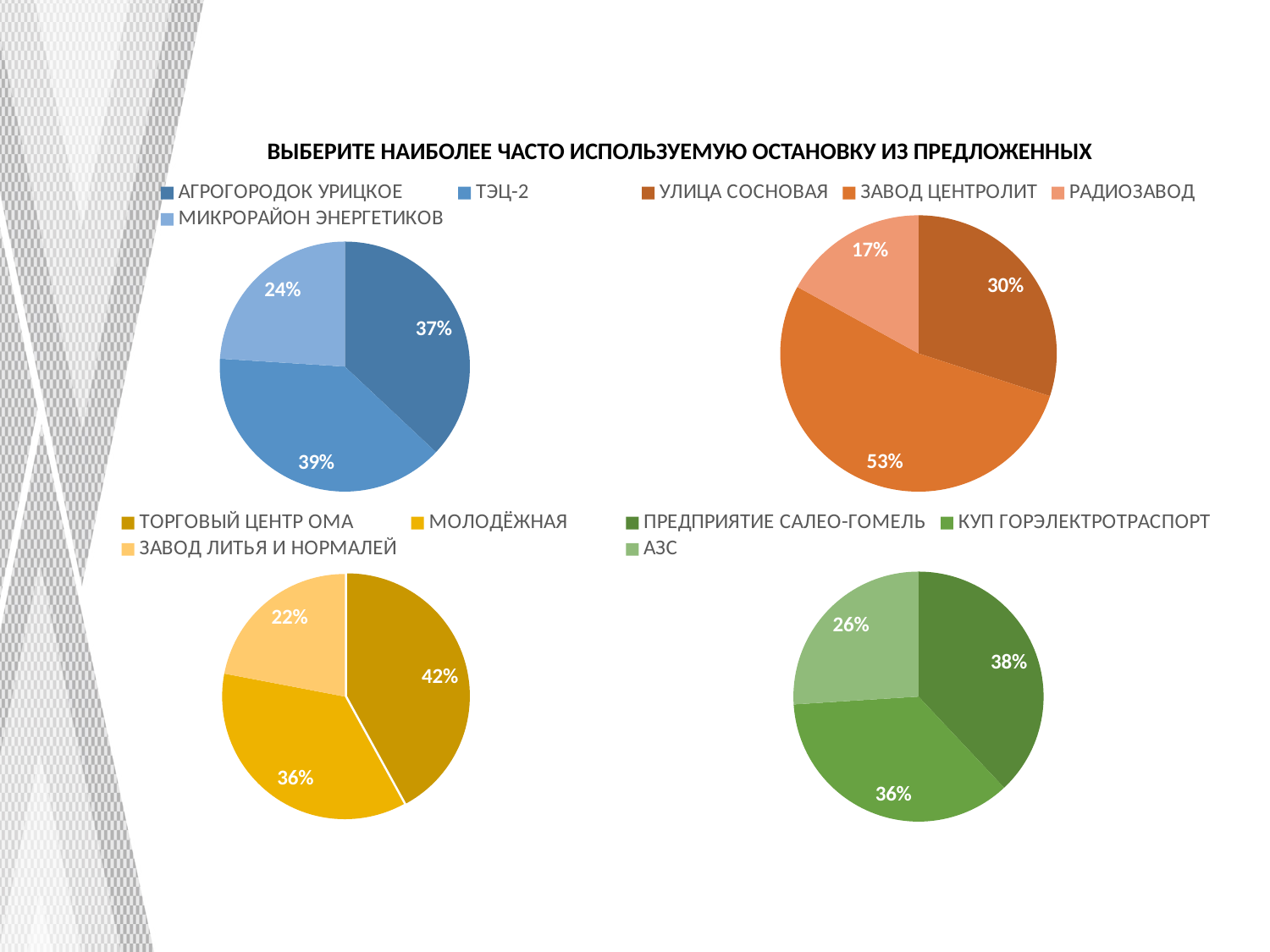
In the bottom-right pie chart, what share does АЗС have? 26% In the bottom-left pie chart, which category has the smallest share? ЗАВОД ЛИТЬЯ И НОРМАЛЕЙ In the top-right pie chart, what is the difference between the shares of ЗАВОД ЦЕНТРОЛИТ and УЛИЦА СОСНОВАЯ? 23% In the bottom-left pie chart, what share does ТОРГОВЫЙ ЦЕНТР ОМА have? 42% How many charts are shown on the slide? 4 What type of chart is the top-left chart? Pie chart How many slices does the bottom-right pie chart have? 3 In the top-right pie chart, which category has the largest share? ЗАВОД ЦЕНТРОЛИТ In the top-left pie chart, what share does МИКРОРАЙОН ЭНЕРГЕТИКОВ have? 24% In the bottom-right pie chart, which is larger: ПРЕДПРИЯТИЕ САЛЕО-ГОМЕЛЬ or КУП ГОРЭЛЕКТРОТРАСПОРТ? ПРЕДПРИЯТИЕ САЛЕО-ГОМЕЛЬ In the top-left pie chart, what share does ТЭЦ-2 have? 39% In the top-right pie chart, what share does РАДИОЗАВОД have? 17%